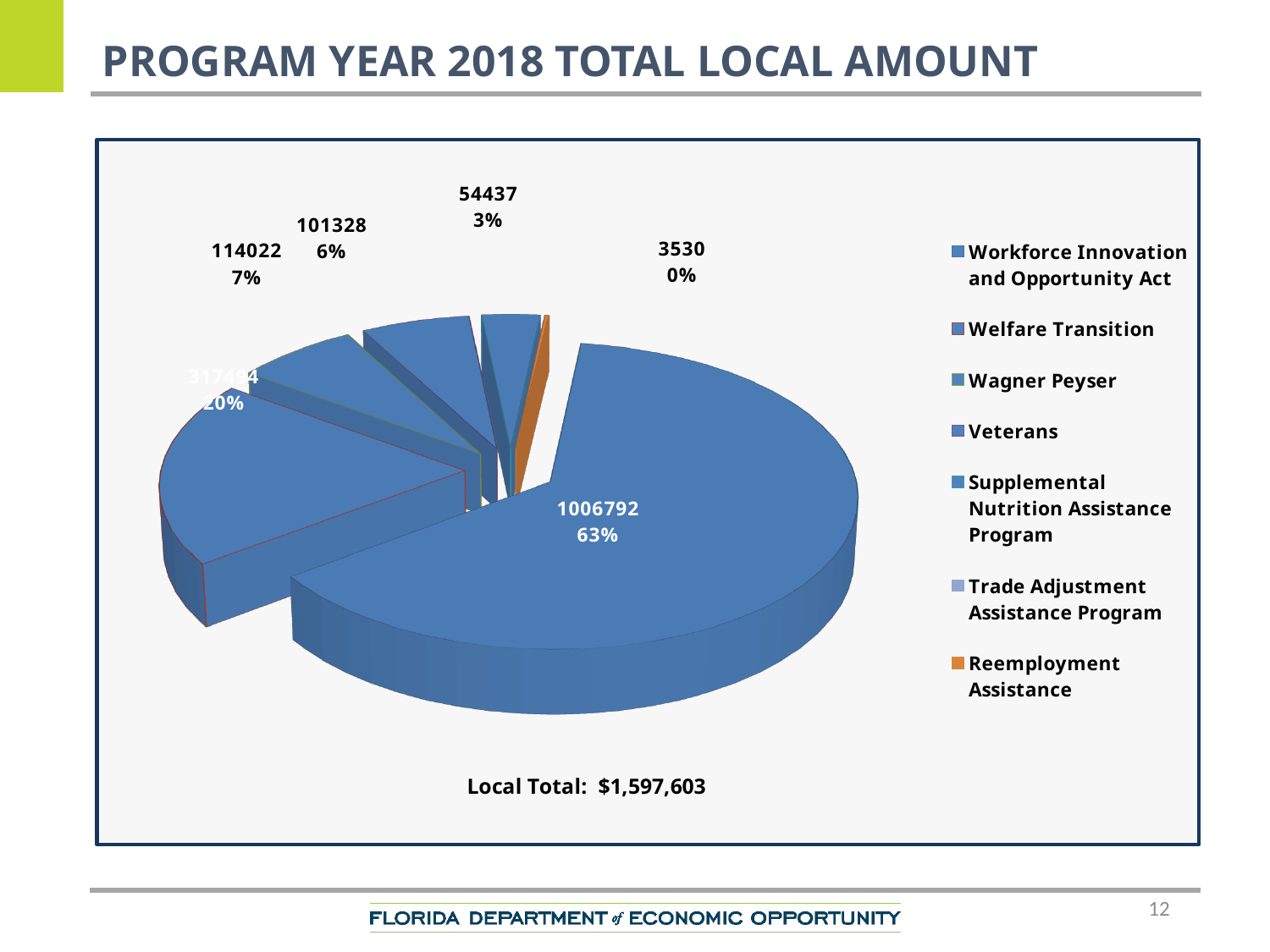
How many categories does the legend of the pie chart list? 7 What value is labeled on the slice showing 0%? 3530 What percentage is shown for the slice labeled 114022? 7% What value is labeled on the largest slice of the pie chart? 1006792 What is the title of the slide containing the pie chart? PROGRAM YEAR 2018 TOTAL LOCAL AMOUNT What is the Local Total shown below the pie chart? $1,597,603 Which legend category corresponds to the largest slice of the pie (63%)? Workforce Innovation and Opportunity Act What share of the pie does the largest slice represent? 63% What percentage is shown for the slice labeled 54437? 3% Which is larger, the slice labeled 114022 or the slice labeled 54437? 114022 What kind of chart is shown on the slide? pie chart What percentage is shown for the slice labeled 101328? 6%